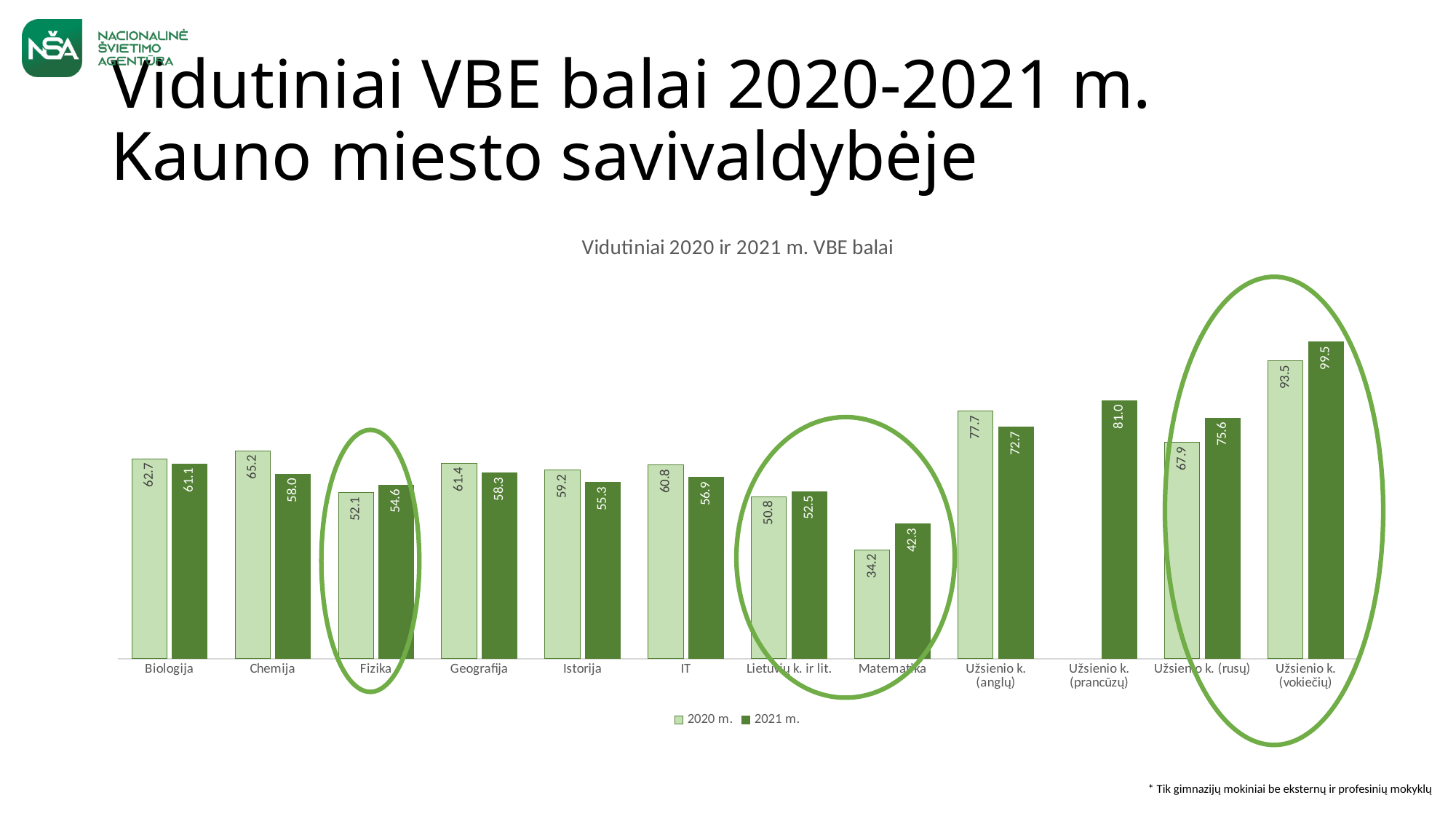
What is the 2020 m. value for Matematika? 34.2 Which is larger for Užsienio k. (rusų): the 2020 m. value or the 2021 m. value? 2021 m. How many categories are shown on the x axis? 12 Which category has the lowest 2020 m. value? Matematika What is the 2021 m. value for Užsienio k. (vokiečių)? 99.5 What is the difference between the 2020 m. and 2021 m. values for Chemija? 7.2 How many series does the legend list? 2 What is the difference between the 2021 m. and 2020 m. values for Matematika? 8.1 What is the 2020 m. value for Chemija? 65.2 What kind of chart is shown on the slide? Bar chart Which category has the highest 2021 m. value? Užsienio k. (vokiečių) What is the 2021 m. value for Užsienio k. (prancūzų)? 81.0